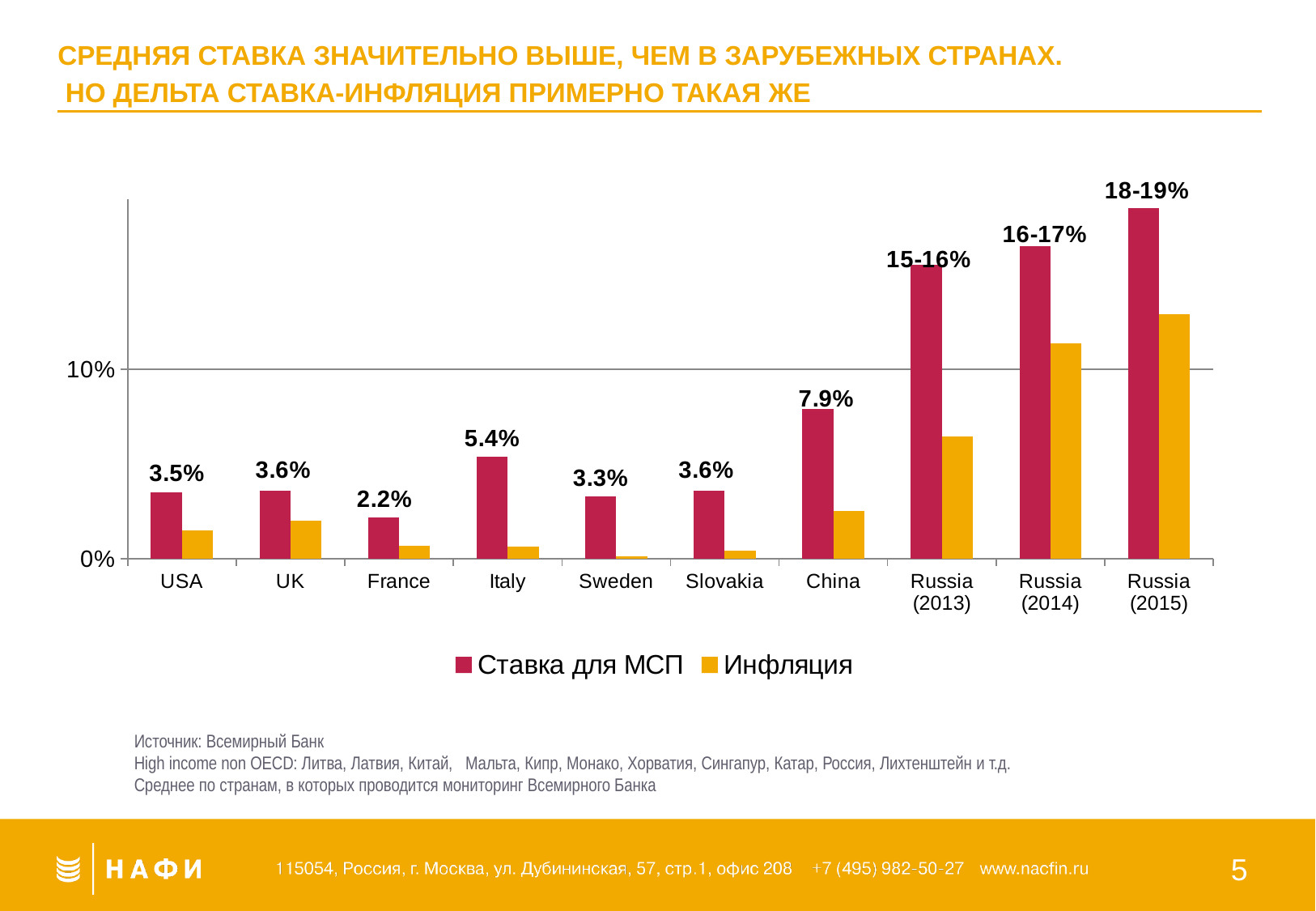
Which category has the lowest Ставка для МСП? France What is the value of Ставка для МСП for Italy? 5.4% Is the Инфляция value for Russia (2013) greater or less than 10%? less Is the Инфляция value for Russia (2015) greater or less than 10%? greater What is the value of Ставка для МСП for France? 2.2% How many series does the legend list? 2 What is the difference between the Ставка для МСП for China and for USA? 4.4% What is the value of Ставка для МСП for China? 7.9% How many categories are shown on the x axis of the chart? 10 Which category has the highest Ставка для МСП? Russia (2015) Which has a higher Ставка для МСП, Italy or UK? Italy What is the value of Ставка для МСП for Russia (2015)? 18-19%